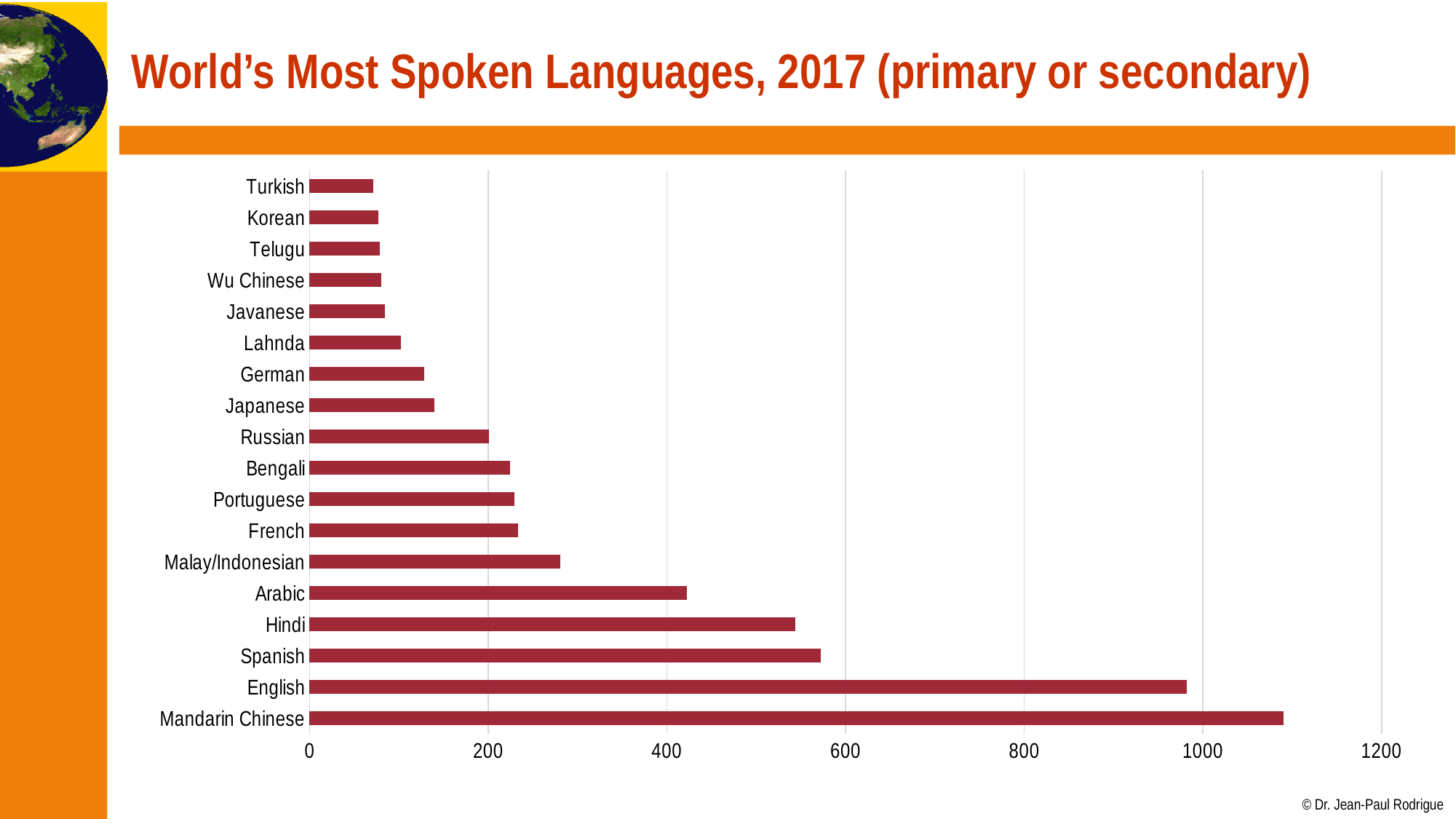
Which has a larger value, English or Spanish? English How many languages are listed in the chart? 18 Is the value for Malay/Indonesian greater or less than 400? less Is the value for Japanese greater or less than 200? less Is the value for English greater or less than 800? greater Which language has the highest value in the chart? Mandarin Chinese What is the title of the slide containing the chart? World's Most Spoken Languages, 2017 (primary or secondary) What kind of chart is shown on the slide? bar chart Which has a larger value, Arabic or Malay/Indonesian? Arabic